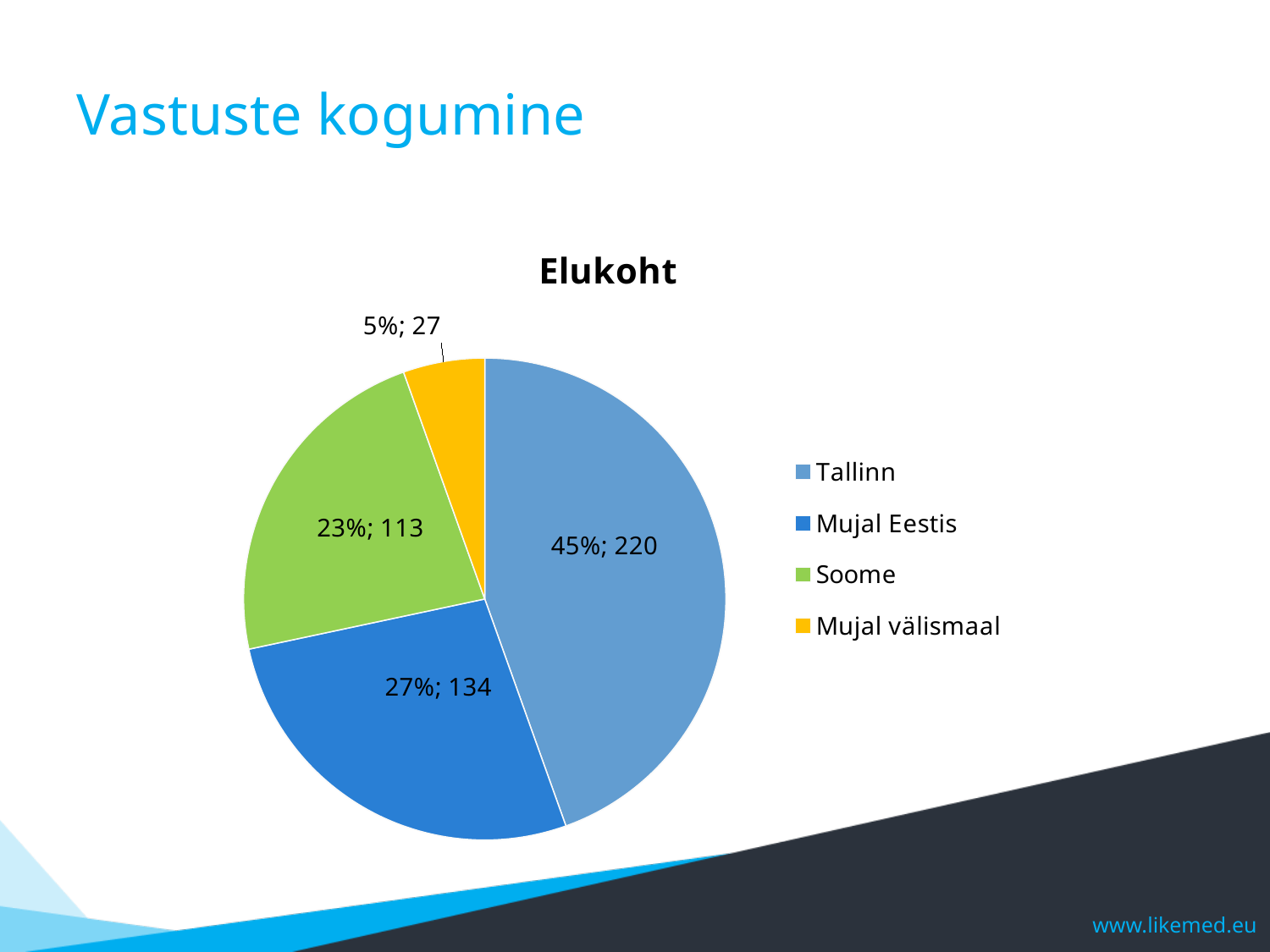
What is the title of the chart? Elukoht How many slices does the pie chart have? 4 What percentage share does Mujal välismaal have? 5% Which category has the smallest slice? Mujal välismaal Which category has the largest slice? Tallinn What is the count shown for Tallinn? 220 Which is larger, the count for Soome or the count for Mujal Eestis? Mujal Eestis What is the difference in count between Tallinn and Mujal Eestis? 86 What is the count shown for Mujal Eestis? 134 Which legend entry is shown in yellow? Mujal välismaal What percentage share does Soome have? 23% What kind of chart is shown on the slide? pie chart